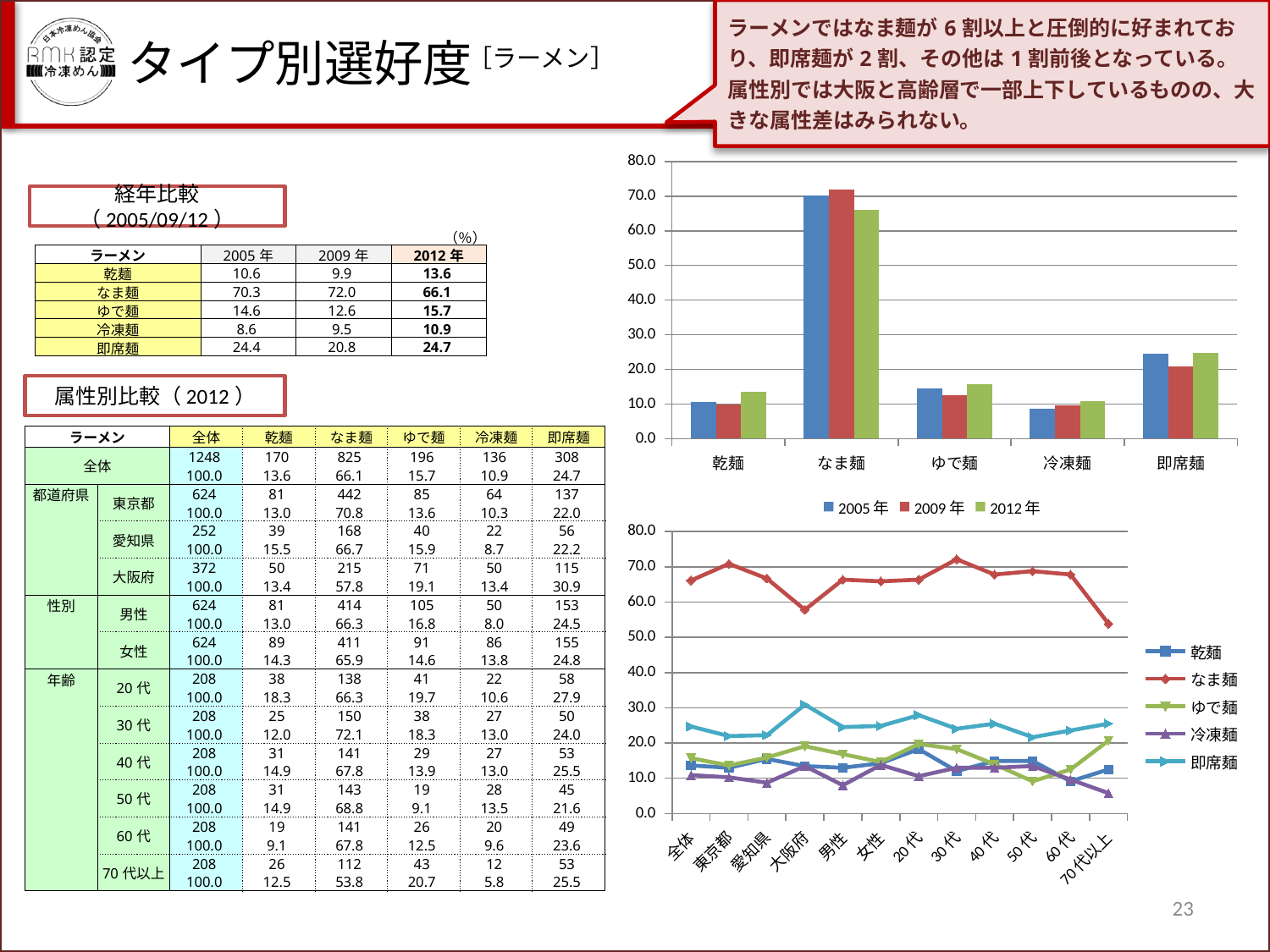
In the bottom-right line chart, at which category is the なま麺 line lowest? 70代以上 In the top-right bar chart, which category has the highest value for 2012年? なま麺 What kind of chart is the top-right chart comparing 2005年, 2009年 and 2012年? bar chart In the top-right bar chart, which is larger for 即席麺: the 2005年 value or the 2009年 value? 2005年 In the top-right bar chart, what is the value for なま麺 in 2009年? 72.0 In the bottom-right line chart, how many series does the legend list? 5 In the top-right bar chart, is the 2012年 value for なま麺 greater or less than 60? greater In the bottom-right line chart, is the なま麺 value for 大阪府 greater or less than 60? less In the top-right bar chart, how many noodle-type categories are shown on the x axis? 5 In the bottom-right line chart, how many attribute categories are plotted along the x axis? 12 In the top-right bar chart, how many series does the legend list? 3 In the bottom-right line chart, what colour is the なま麺 line? red